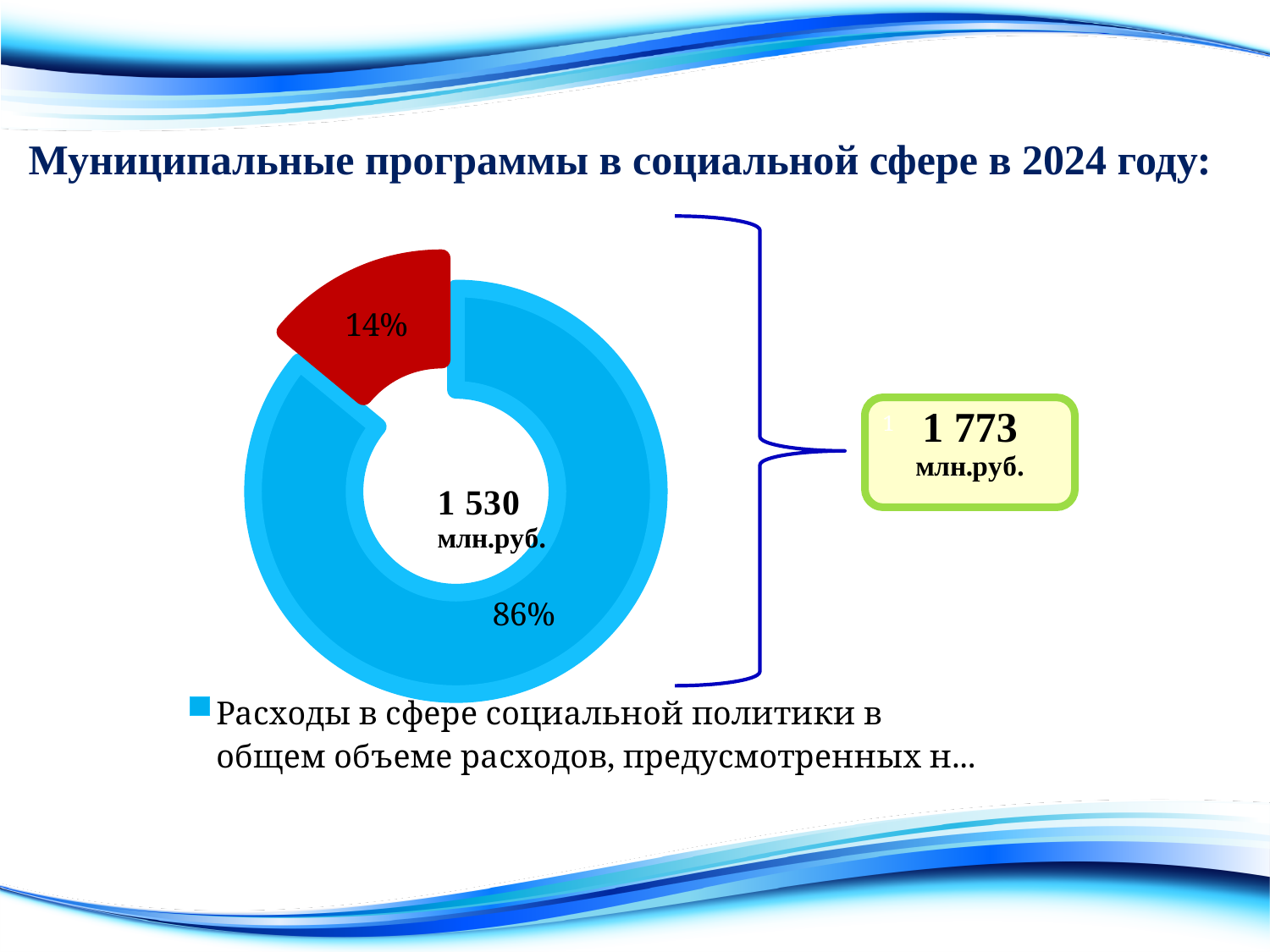
By how many percentage points does the blue slice exceed the red slice? 72 percentage points What colour is the largest slice of the donut chart? Blue What share of the donut chart does the blue slice (Расходы в сфере социальной политики) represent? 86% Which is larger, the blue slice or the red slice? The blue slice How many entries does the chart legend list? 1 How many slices does the donut chart have? 2 What value is printed in the centre of the donut chart? 1 530 млн.руб. What kind of chart is shown on the slide? Pie chart (donut) Is the share of the red slice greater or less than 50%? less What share of the donut chart does the red slice represent? 14% Which slice of the donut chart is the largest? The blue slice (86%) Which slice of the donut chart is the smallest? The red slice (14%)